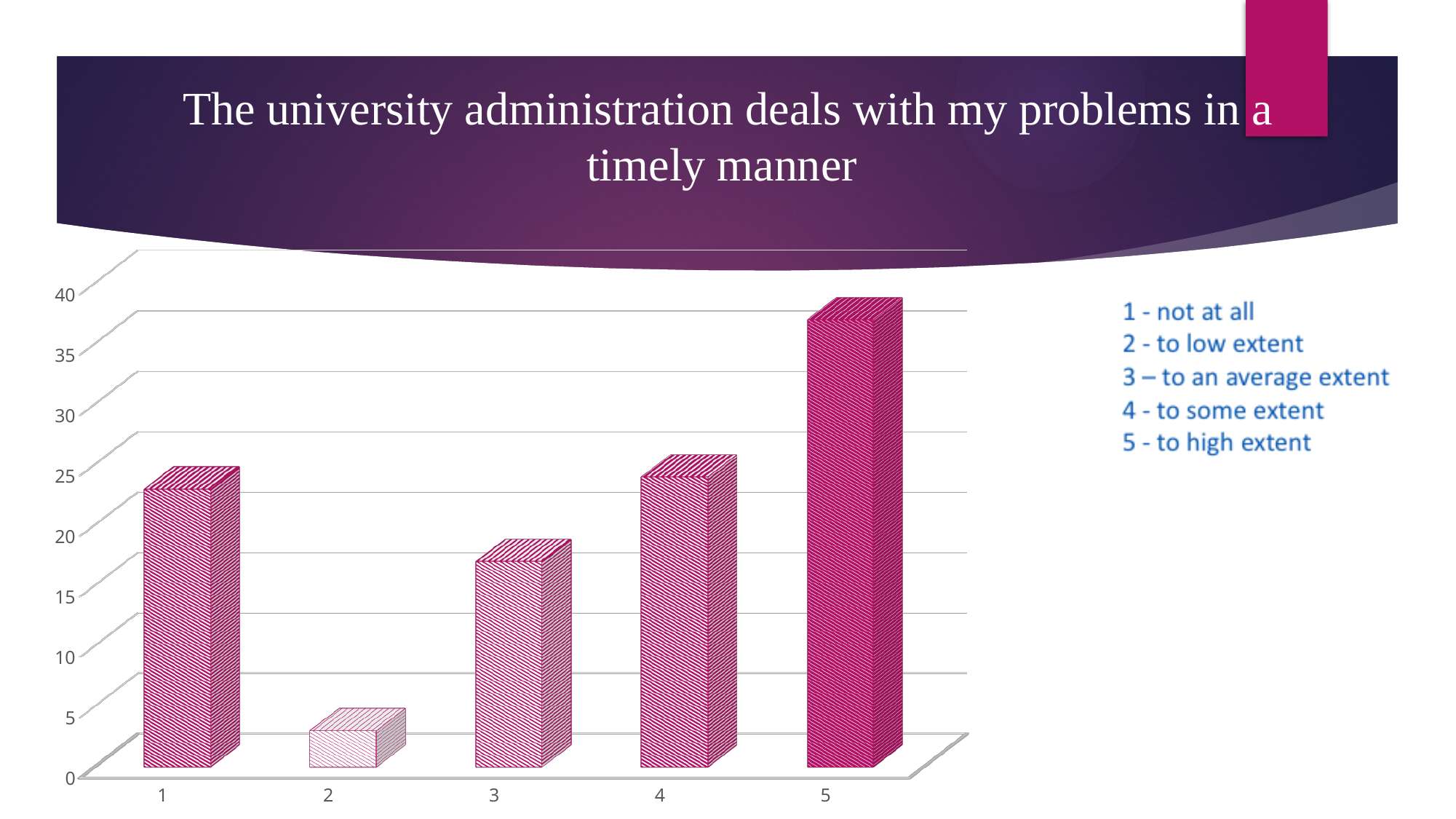
Is the value for category 3 greater or less than 15? greater Is the value for category 5 greater or less than 35? greater Is the value for category 1 greater or less than 20? greater Which category has the highest bar? 5 Which has the larger value, category 1 or category 3? 1 How many categories are plotted on the x axis? 5 Which has the larger value, category 3 or category 5? 5 What kind of chart is shown on the slide? bar chart According to the key on the slide, what does category 5 stand for? to high extent Which category has the lowest bar? 2